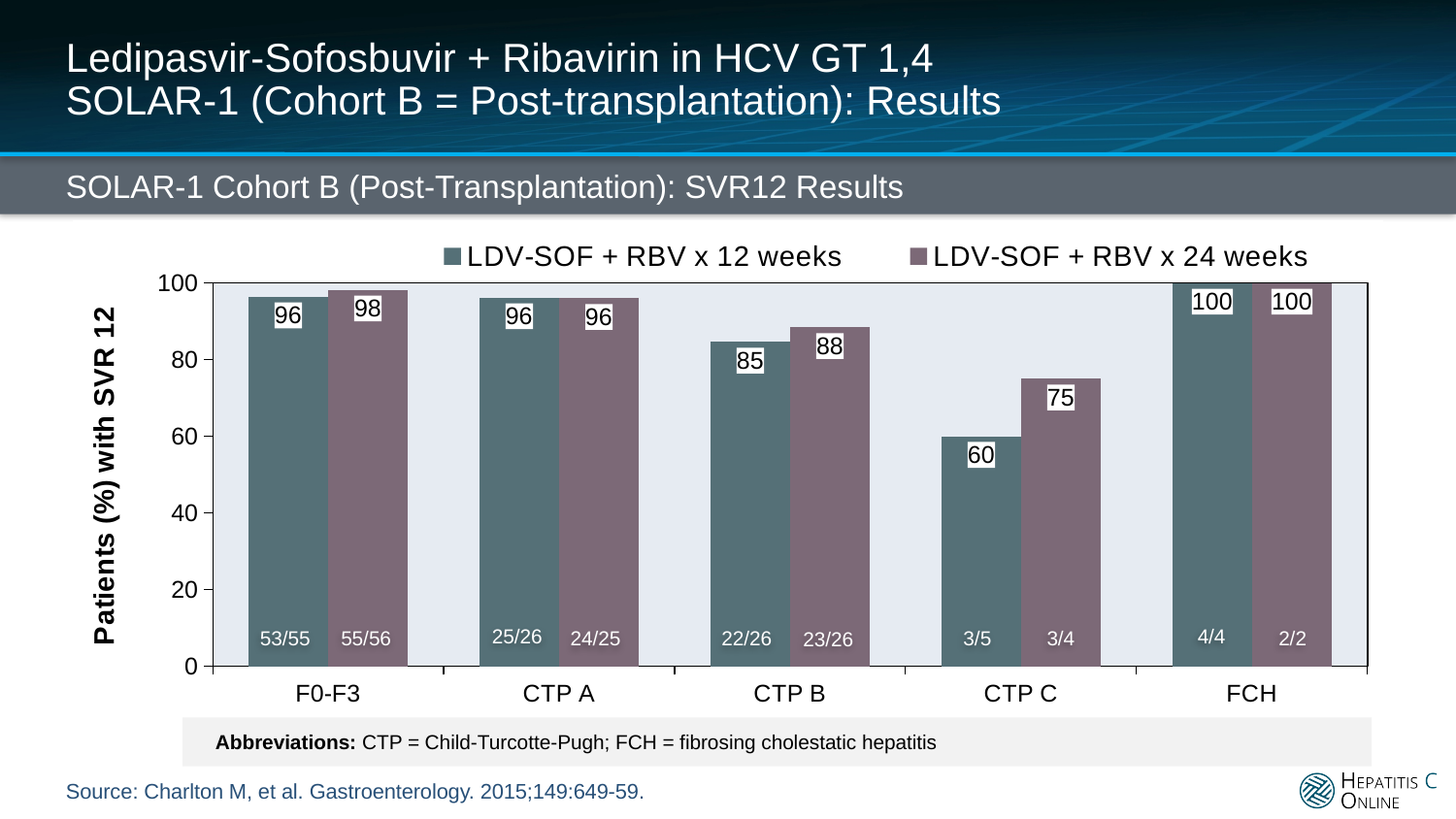
For CTP B, which regimen has the higher SVR12 rate, 12 weeks or 24 weeks? LDV-SOF + RBV x 24 weeks How many series does the legend list? 2 Which category has the highest SVR12 rate for the LDV-SOF + RBV x 24 weeks series? FCH What is the difference between the 24-week and 12-week SVR12 rates for CTP C? 15 How many patient categories are shown on the x axis? 5 Which category has the lowest SVR12 rate for the LDV-SOF + RBV x 12 weeks series? CTP C Is the SVR12 rate for CTP C with LDV-SOF + RBV x 24 weeks greater or less than 60? greater What kind of chart is shown on the slide? Bar chart What is the SVR12 rate for F0-F3 patients treated with LDV-SOF + RBV x 24 weeks? 98 What is the title of the chart? SOLAR-1 Cohort B (Post-Transplantation): SVR12 Results What is the SVR12 rate for CTP B patients treated with LDV-SOF + RBV x 24 weeks? 88 What is the SVR12 rate for CTP C patients treated with LDV-SOF + RBV x 12 weeks? 60